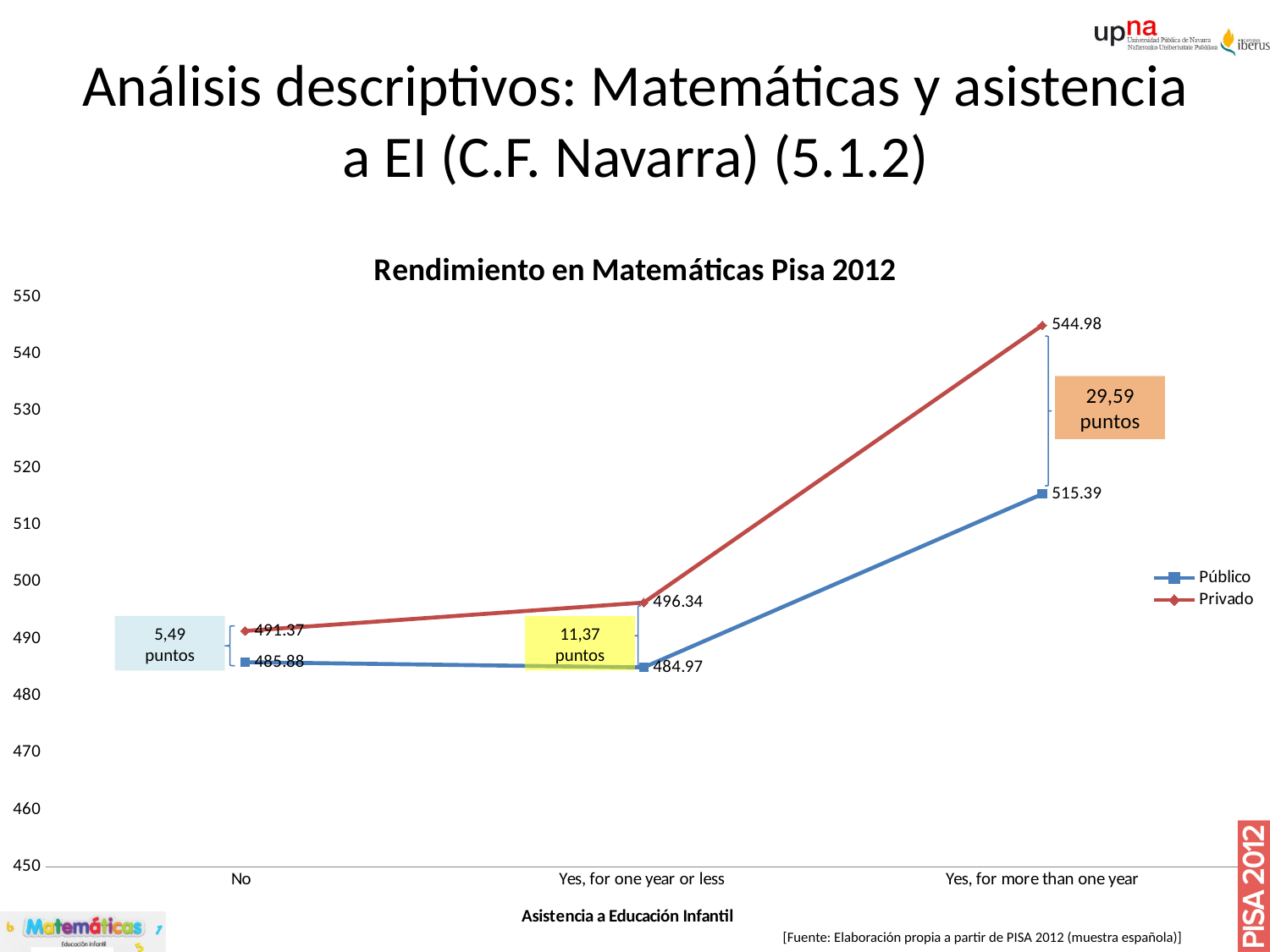
What is the value for Privado at 'Yes, for more than one year'? 544.98 What is the difference between Privado and Público at 'Yes, for more than one year'? 29.59 How many categories are shown on the x axis? 3 Which is larger at 'No': the Público value or the Privado value? Privado How many series does the legend list? 2 What is the value for Público at 'Yes, for one year or less'? 484.97 What is the value for Público at 'No'? 485.88 Is the value for Privado at 'Yes, for more than one year' greater or less than 540? greater What kind of chart is shown on the slide? Line chart Which category has the lowest value for the Público series? Yes, for one year or less What is the value for Privado at 'Yes, for one year or less'? 496.34 Which category has the highest value for the Público series? Yes, for more than one year